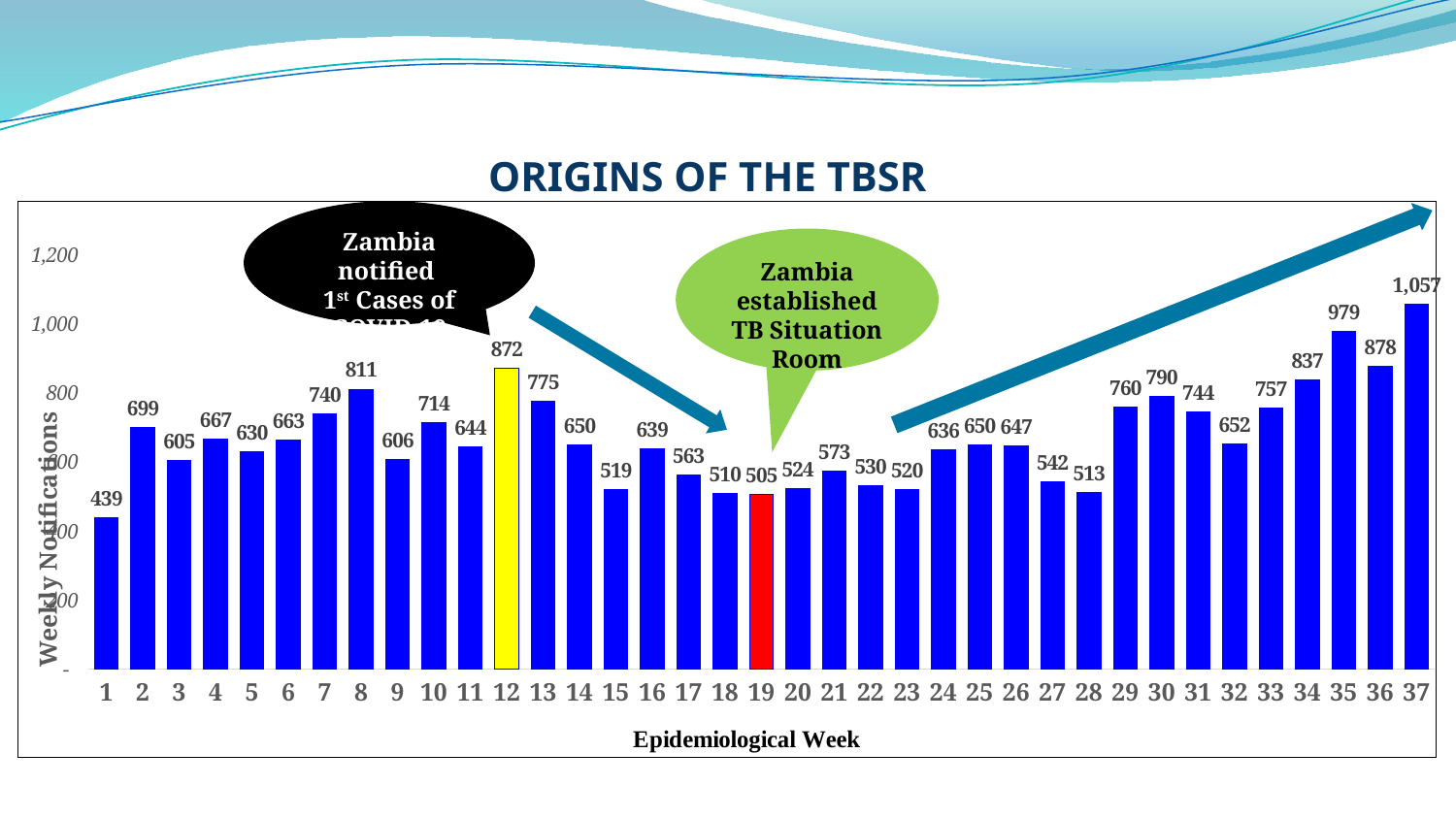
Which epidemiological week has the lowest weekly notifications? 1 What is the value of weekly notifications for epidemiological week 12? 872 What type of chart is shown on the slide? bar chart Which epidemiological week has the highest weekly notifications? 37 What is the difference in weekly notifications between week 37 and week 19? 552 Which has more weekly notifications, week 8 or week 13? week 8 Do weekly notifications rise or fall from week 29 to week 37? rise How many epidemiological weeks are plotted on the chart? 37 What is the value of weekly notifications for epidemiological week 1? 439 What is the value of weekly notifications for epidemiological week 19? 505 What colour is the bar for epidemiological week 19? red Is the value for week 35 greater or less than 800? greater